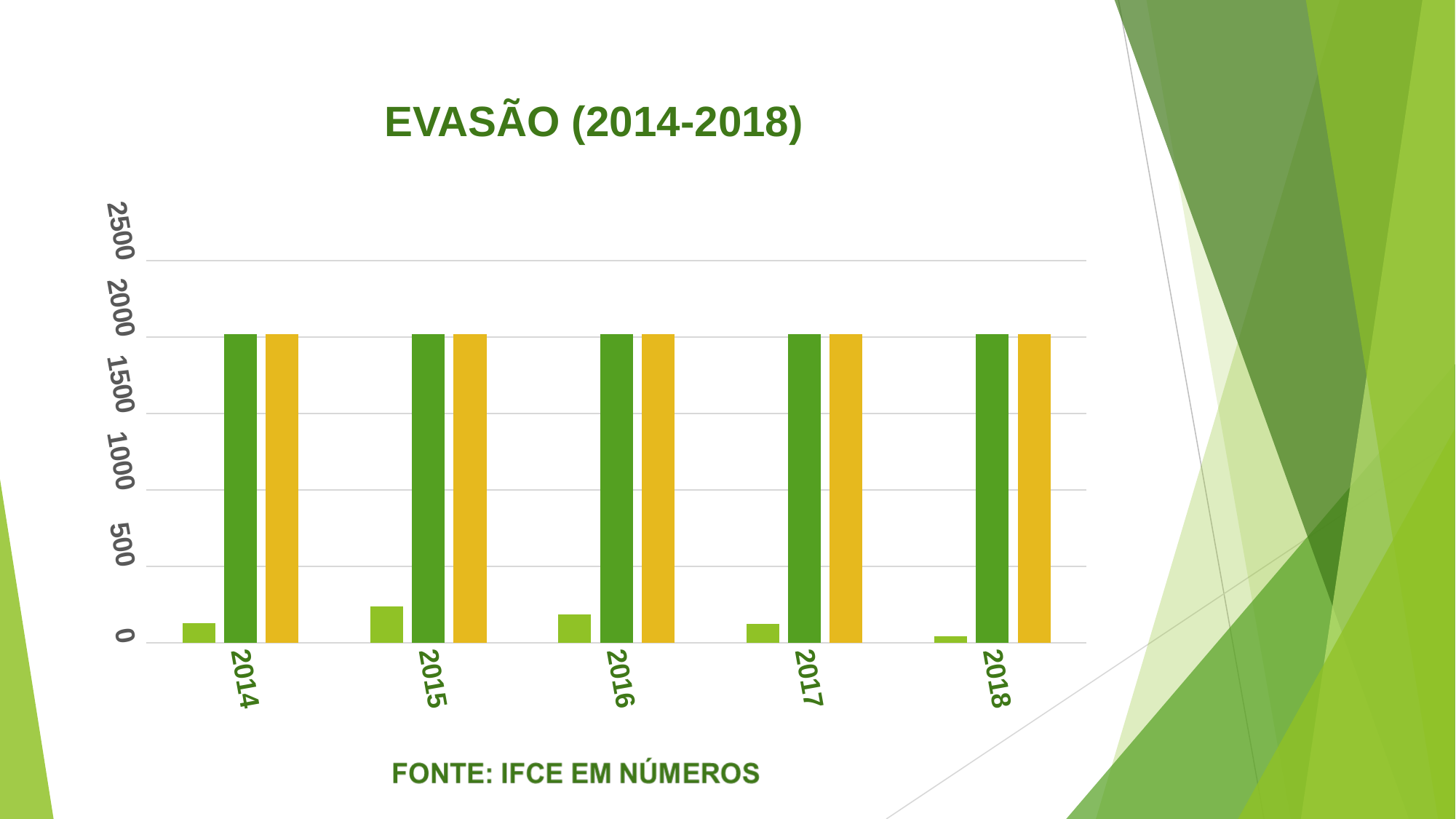
Is the value of the yellow bar for 2018 greater or less than 1500? greater In which year is the light green bar the lowest? 2018 In which year is the light green bar the highest? 2015 Which is larger, the light green bar for 2015 or the light green bar for 2018? 2015 How many years are shown on the x axis of the chart? 5 Which is larger for 2016, the dark green bar or the light green bar? the dark green bar What kind of chart is shown on the slide? bar chart Is the value of the light green bar for 2018 greater or less than 500? less Is the value of the dark green bar for 2014 greater or less than 1500? greater What source is cited below the chart? FONTE: IFCE EM NÚMEROS What is the title of the chart? EVASÃO (2014-2018)